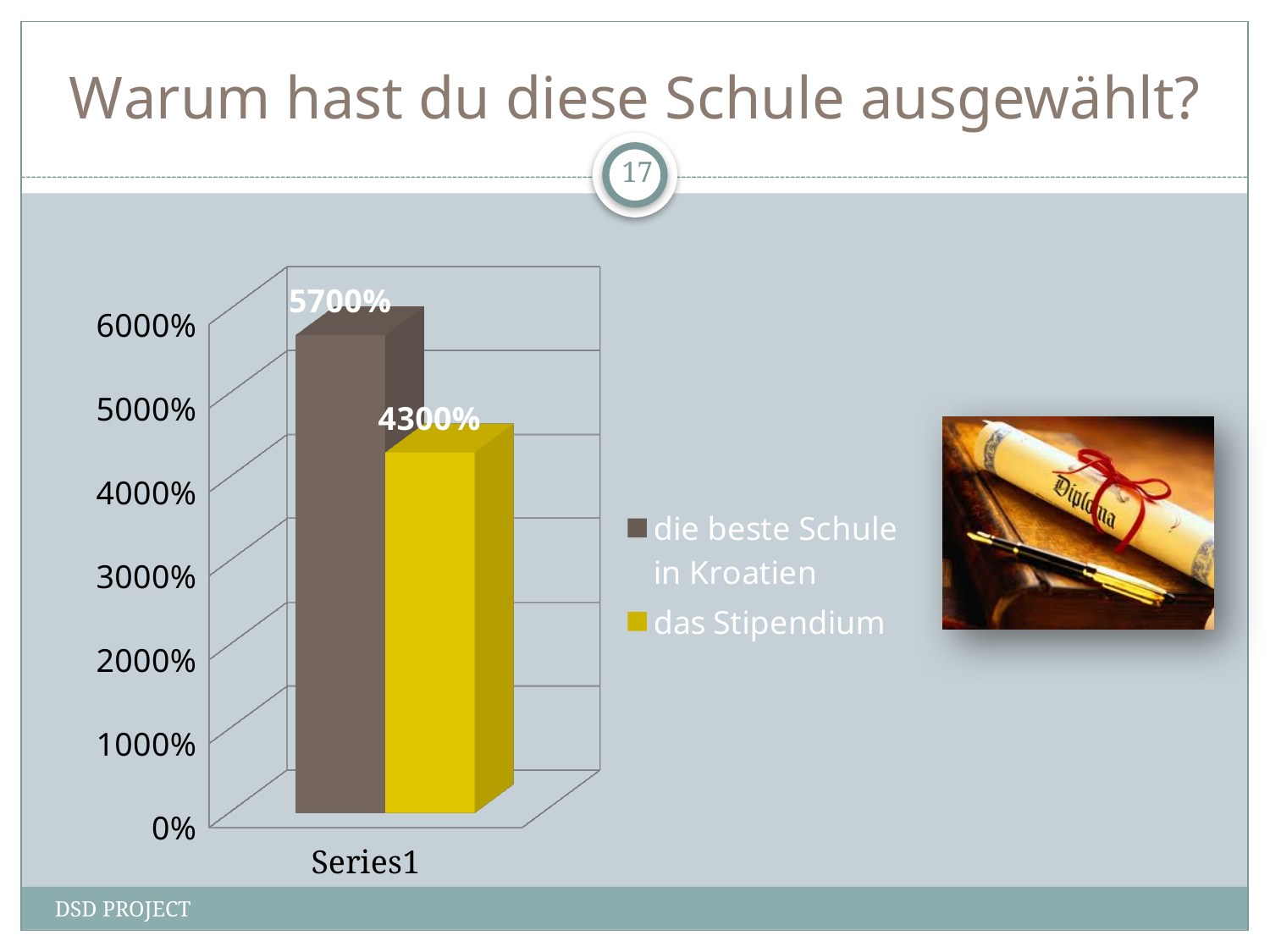
What is the value for "die beste Schule in Kroatien"? 5700% What kind of chart is shown on the slide? bar chart Is the value for "das Stipendium" greater or less than 5000%? less Which legend entry has the highest value? die beste Schule in Kroatien What is the label shown on the category axis of the chart? Series1 What is the difference between the values for "die beste Schule in Kroatien" and "das Stipendium"? 1400% What colour is the bar for "das Stipendium"? yellow Which is larger, the value for "die beste Schule in Kroatien" or the value for "das Stipendium"? die beste Schule in Kroatien How many series does the legend list? 2 Which legend entry has the lowest value? das Stipendium Is the value for "die beste Schule in Kroatien" greater or less than 5000%? greater What is the value for "das Stipendium"? 4300%